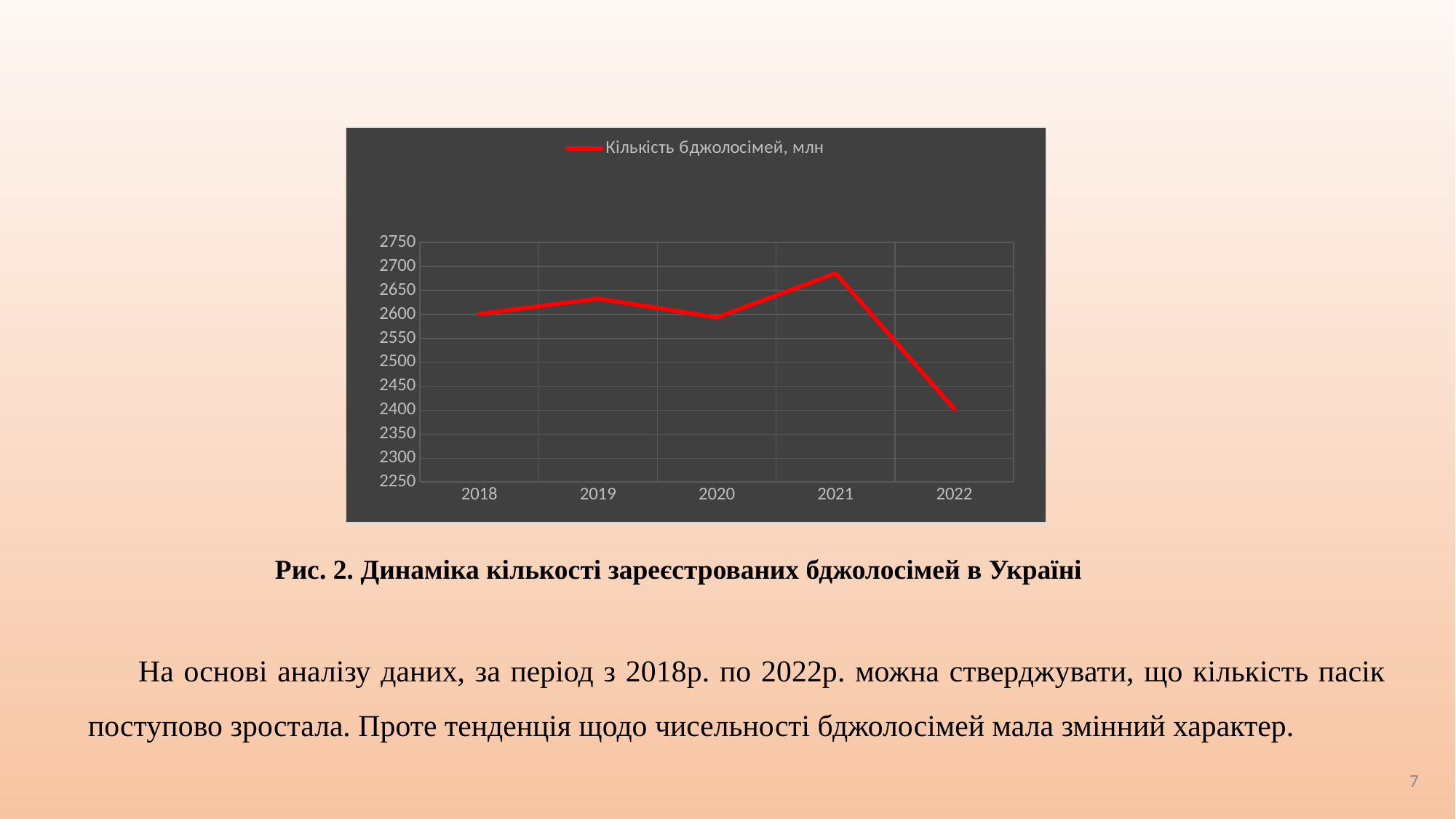
How many years are plotted on the x axis of the chart? 5 In which year is the number of bee colonies highest? 2021 Is the value for 2021 greater or less than 2650? greater Which year has the larger value, 2019 or 2020? 2019 What is the name of the series shown in the chart legend? Кількість бджолосімей, млн What kind of chart is shown on the slide? line chart In which year is the number of bee colonies lowest? 2022 Is the value for 2022 greater or less than 2500? less Is the value for 2019 greater or less than 2600? greater How many series does the chart legend list? 1 Does the value rise or fall from 2021 to 2022? fall